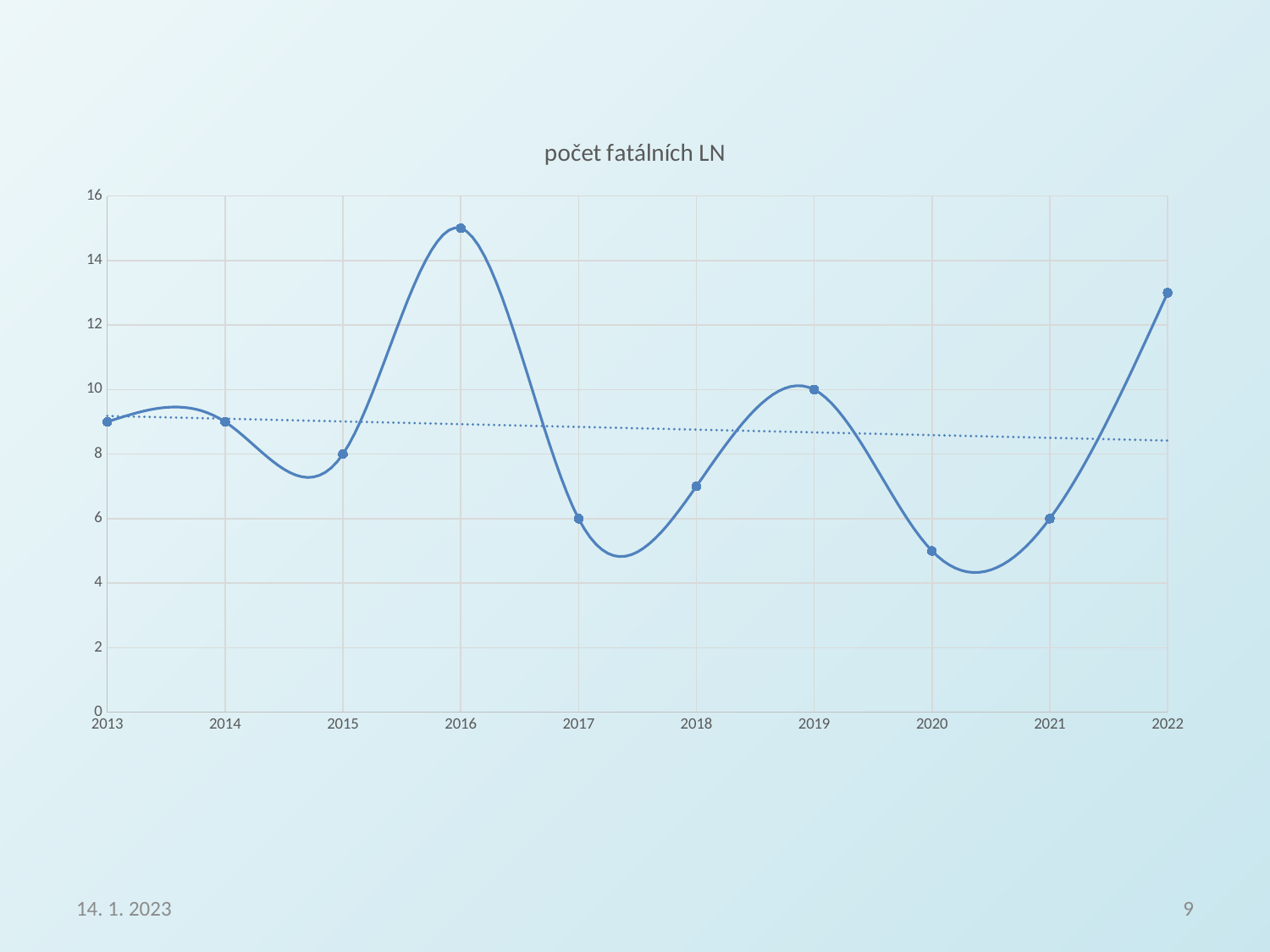
Which year has the lowest value? 2020 What kind of chart is shown on the slide? line chart What is the value for 2017? 6 What is the value for 2015? 8 What is the difference between the values for 2019 and 2017? 4 What is the title of the chart? počet fatálních LN Is the value for 2016 greater or less than 14? greater What is the value for 2019? 10 Is the value for 2022 greater or less than 12? greater Which year has the highest value? 2016 What is the value for 2021? 6 How many data points are plotted on the line? 10